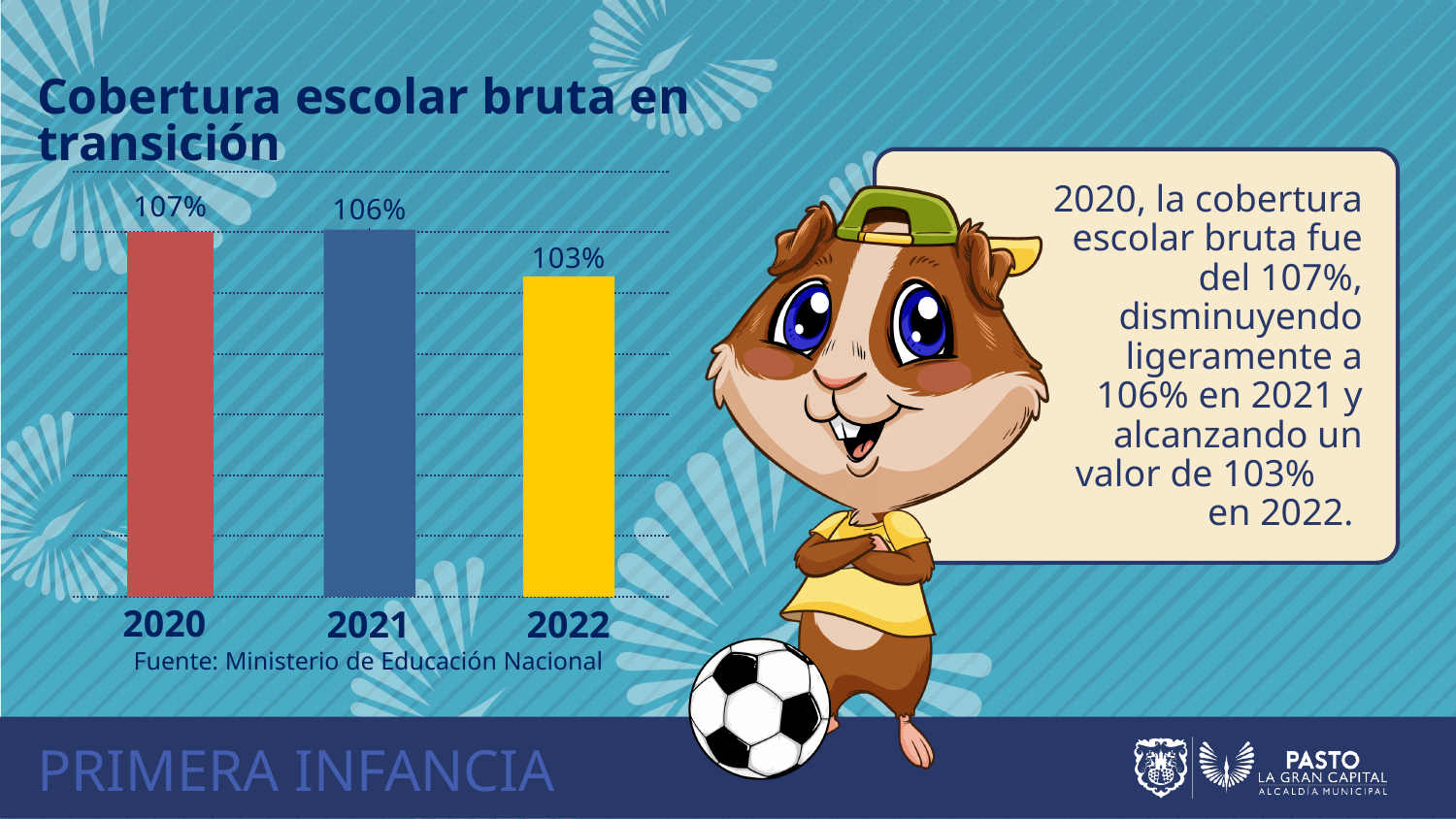
How many years are shown in the chart? 3 What is the title of the chart? Cobertura escolar bruta en transición Which year has the highest gross school coverage in transition? 2020 What is the gross school coverage in transition for 2021? 106% What is the difference in gross school coverage between 2021 and 2022? 3% What is the gross school coverage in transition for 2020? 107% What kind of chart is shown on the slide? Bar chart What is the difference in gross school coverage between 2020 and 2022? 4% What is the gross school coverage in transition for 2022? 103% Which year has the lowest gross school coverage in transition? 2022 Do the values rise or fall from 2020 to 2022? Fall Which year has a higher gross school coverage, 2021 or 2022? 2021